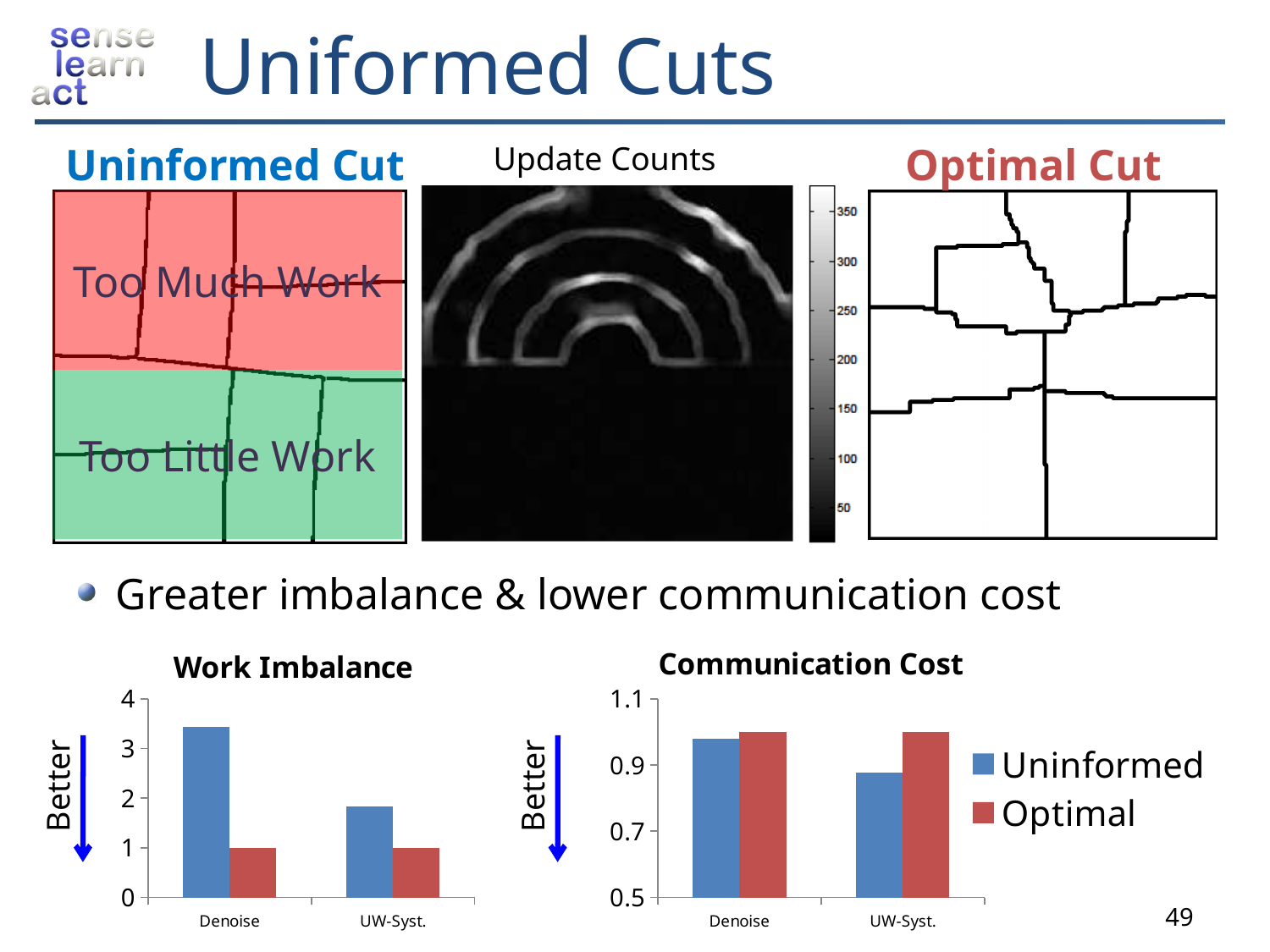
In the Work Imbalance chart, which is larger for Denoise, Uninformed or Optimal? Uninformed In the Communication Cost chart, which bar is the lowest? Uninformed for UW-Syst. In the Work Imbalance chart, is the Uninformed value for Denoise greater or less than 3? greater In the Communication Cost chart, which is larger for UW-Syst., Uninformed or Optimal? Optimal In the Communication Cost chart, is the Uninformed value for UW-Syst. greater or less than 0.9? less In the Work Imbalance chart, which bar is the highest? Uninformed for Denoise What colour represents the Optimal series in the charts? red How many categories are shown on the x axis of the Work Imbalance chart? 2 What kind of chart is the Work Imbalance chart? bar chart How many series does the legend list for the Communication Cost chart? 2 In the Communication Cost chart, is the Optimal value for Denoise greater or less than 0.9? greater